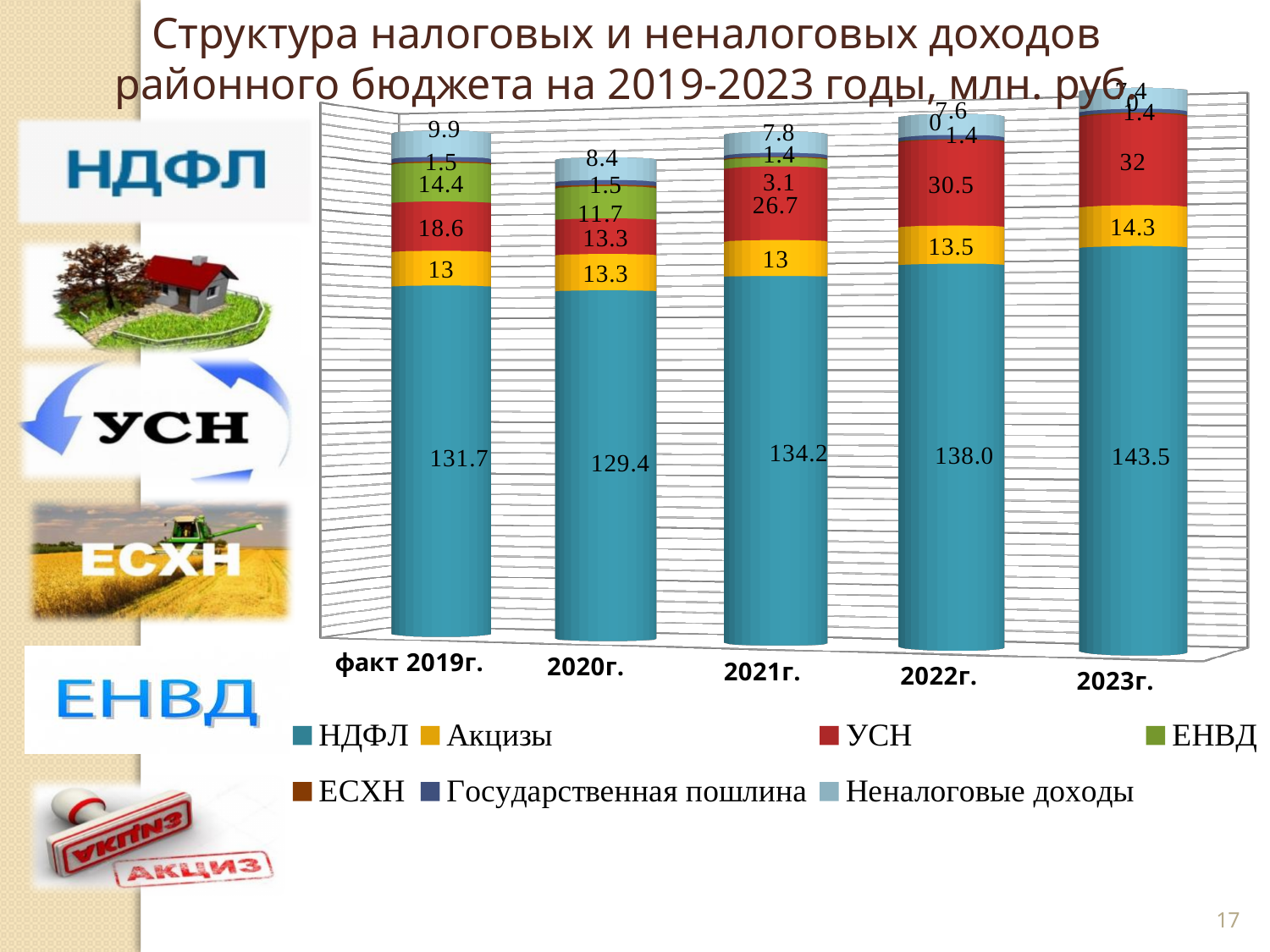
Which year has the lowest НДФЛ value? 2020г. What is the НДФЛ value for 2023г.? 143.5 What is the НДФЛ value for факт 2019г.? 131.7 What type of chart is shown on the slide? stacked bar chart What is the Акцизы value for 2023г.? 14.3 What is the ЕНВД value for 2020г.? 11.7 What is the УСН value for 2022г.? 30.5 Which year has the highest НДФЛ value? 2023г. How many series does the legend list? 7 How many year categories are shown along the x axis? 5 What is the difference between the УСН values for 2023г. and факт 2019г.? 13.4 Is the УСН value larger for 2021г. or for 2020г.? 2021г.